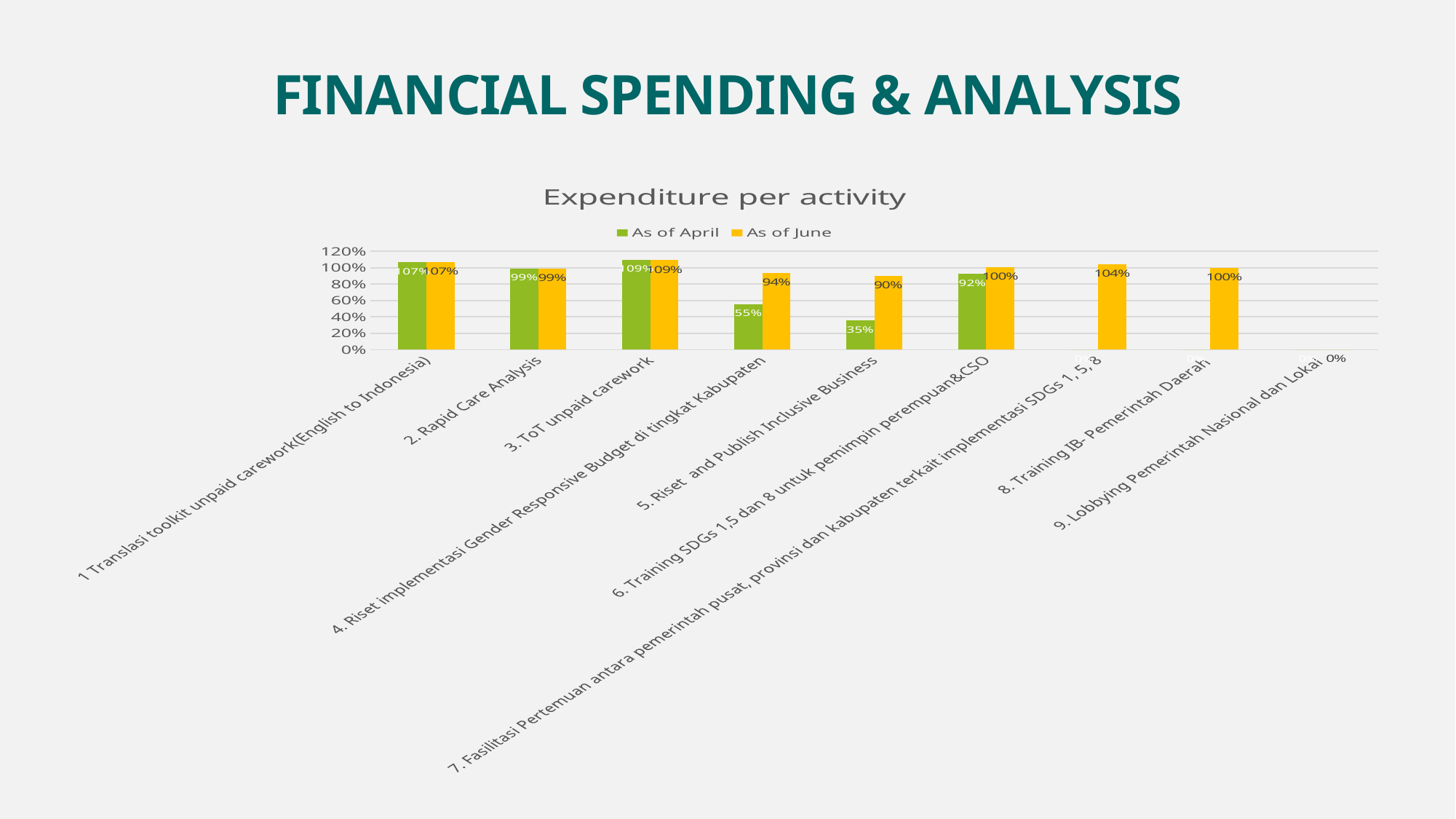
Which activity has the lowest As of June value? 9. Lobbying Pemerintah Nasional dan Lokai Which activity has the highest As of June value? 3. ToT unpaid carework What is the As of June value for '8. Training IB- Pemerintah Daerah'? 100% What kind of chart is shown? Bar chart Which colour represents the 'As of June' series? Yellow Which is larger for '4. Riset implementasi Gender Responsive Budget di tingkat Kabupaten': the As of April value or the As of June value? As of June What is the title of the chart? Expenditure per activity How many series does the legend list? 2 What is the As of April value for '5. Riset and Publish Inclusive Business'? 35% How many activity categories are shown on the x axis? 9 What is the As of June value for '4. Riset implementasi Gender Responsive Budget di tingkat Kabupaten'? 94% What is the difference between the As of June and As of April values for '5. Riset and Publish Inclusive Business'? 55%